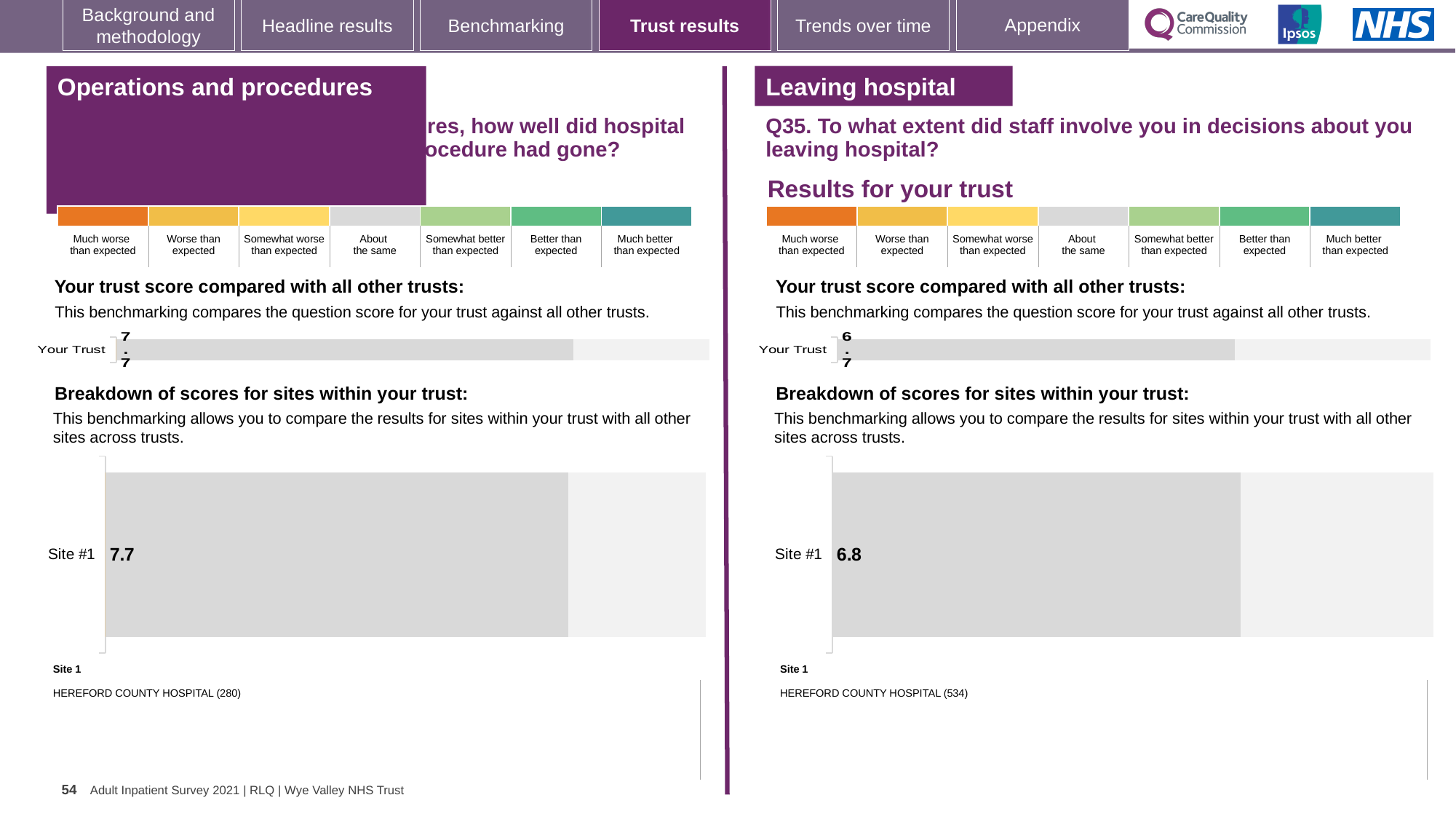
How many sites are shown in the Leaving hospital breakdown of scores for sites within your trust? 1 Which section shows a higher Site #1 score: Operations and procedures or Leaving hospital? Operations and procedures What is the difference between the Site #1 score in the Operations and procedures section and the Site #1 score in the Leaving hospital section? 0.9 In the Leaving hospital section (Q35), what is the 'Your Trust' score shown in the trust benchmarking bar? 6.7 Which is larger: the 'Your Trust' score for Operations and procedures or the 'Your Trust' score for Leaving hospital? Operations and procedures How many categories are shown in the colour scale above the trust benchmarking charts, from 'Much worse than expected' to 'Much better than expected'? 7 What type of chart is used to show the breakdown of scores for sites within the trust? Bar chart In the Leaving hospital section, what is the difference between the Site #1 score and the 'Your Trust' score? 0.1 In the Operations and procedures breakdown of scores for sites, what is the score for Site #1? 7.7 Which hospital is listed as Site 1 in the Leaving hospital section, and what number appears in brackets after it? HEREFORD COUNTY HOSPITAL (534) In the Leaving hospital (Q35) breakdown of scores for sites, what is the score for Site #1? 6.8 In the Operations and procedures section, what is the 'Your Trust' score shown in the trust benchmarking bar? 7.7